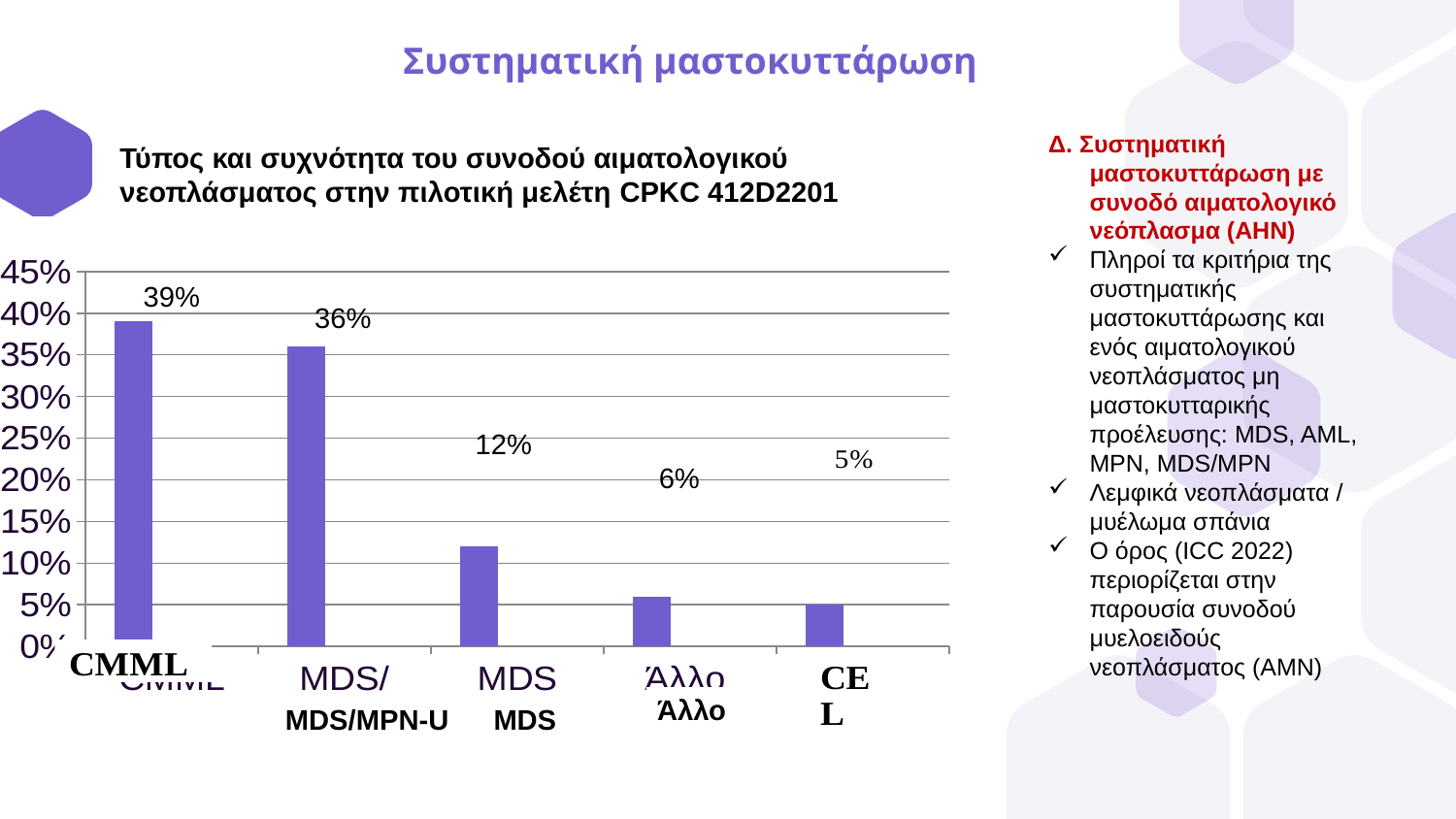
How many categories are shown in the chart? 5 Which category has the highest value? CMML What is the value for MDS/MPN-U? 36% What is the difference between the values for CMML and MDS/MPN-U? 3% What is the value for CEL? 5% Which is larger, the value for MDS or the value for Άλλο? MDS What is the value for Άλλο? 6% What is the value for CMML? 39% Which category has the lowest value? CEL What is the difference between the values for MDS/MPN-U and MDS? 24% What kind of chart is shown on the slide? Bar chart What is the value for MDS? 12%